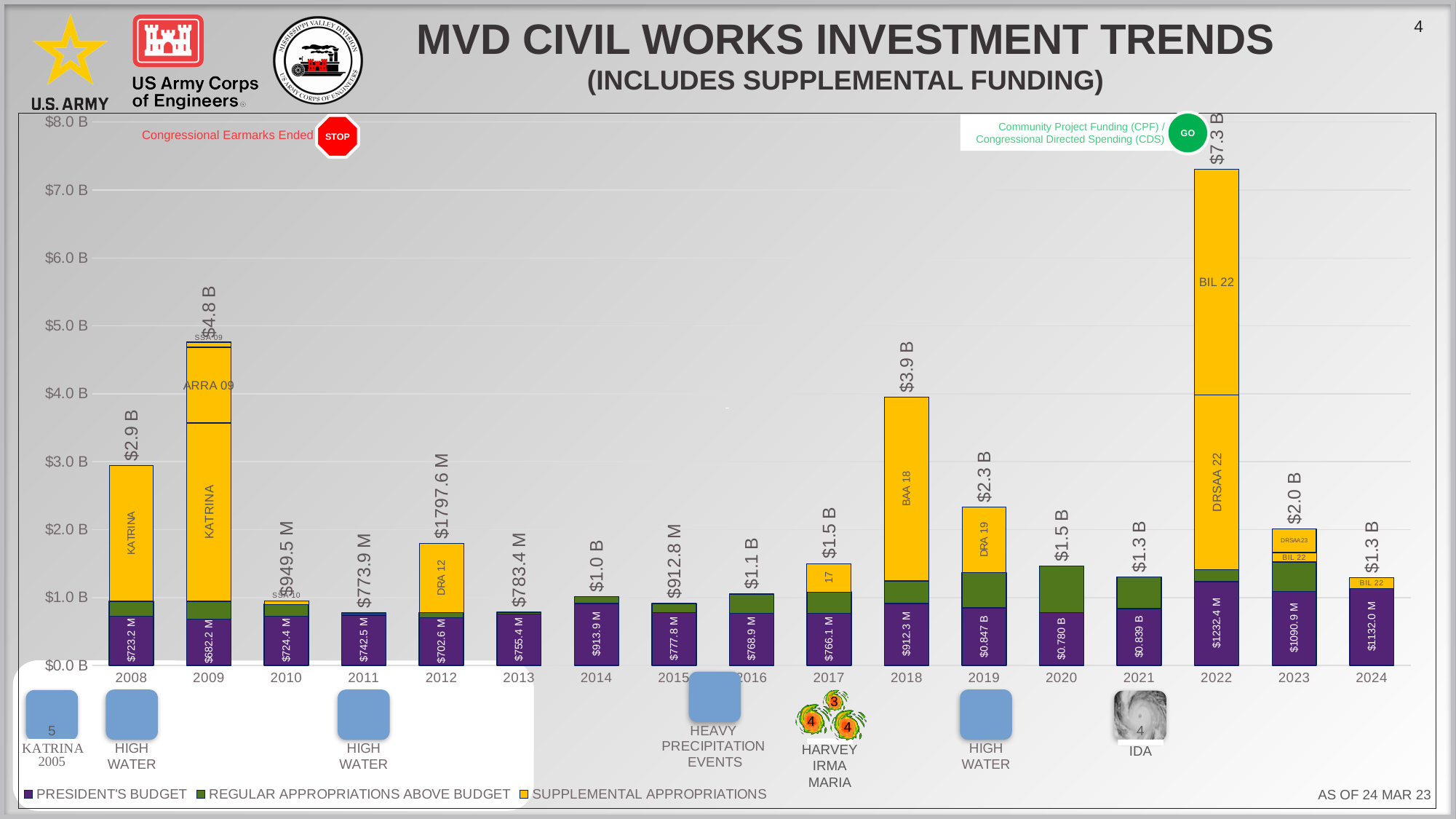
Is the total investment for 2020 greater or less than $1.0 B? greater Which colour represents Supplemental Appropriations in the legend? Yellow What is the President's Budget value labeled for 2014? $913.9 M How many series does the legend list? 3 What is the President's Budget value labeled for 2022? $1232.4 M Which year has the lowest total investment? 2011 What kind of chart is shown on the slide? Stacked bar chart What is the total investment labeled for 2018? $3.9 B Which year has the larger total investment, 2009 or 2018? 2009 What is the difference between the total investment in 2022 and in 2009? $2.5 B How many years are shown along the x axis? 17 Which year has the highest total investment? 2022